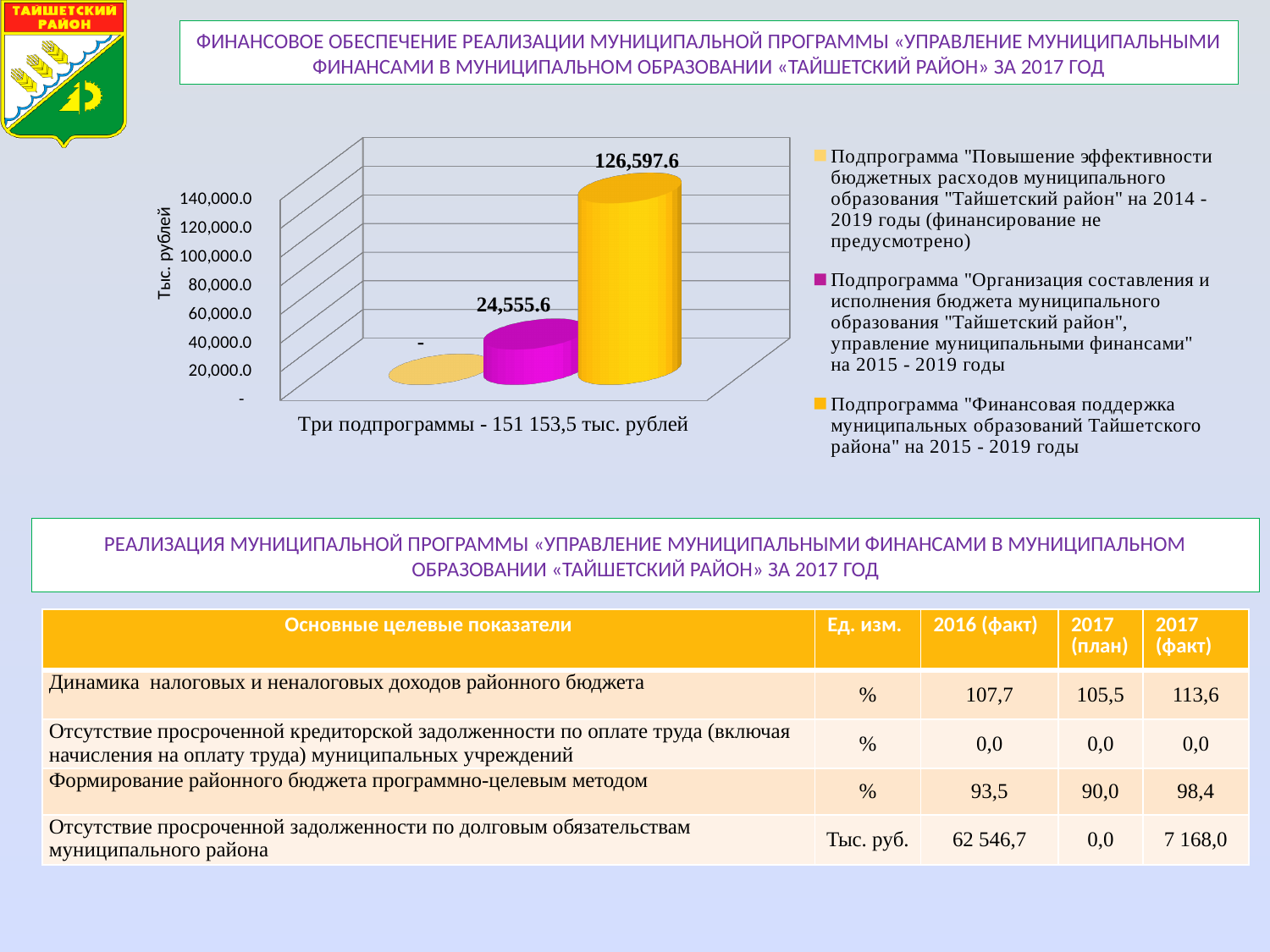
What total amount for the three subprograms is stated in the category label under the chart? 151 153,5 тыс. рублей What is the value for the subprogram "Организация составления и исполнения бюджета муниципального образования "Тайшетский район", управление муниципальными финансами" на 2015 - 2019 годы? 24,555.6 Which is larger: the value for the "Организация составления и исполнения бюджета" subprogram or the "Финансовая поддержка" subprogram? Подпрограмма "Финансовая поддержка муниципальных образований Тайшетского района" на 2015 - 2019 годы How many series does the chart legend list? 3 What unit is shown on the vertical axis of the chart? Тыс. рублей Is the value for the "Финансовая поддержка" subprogram greater or less than 120,000.0? greater What is the value for the subprogram "Финансовая поддержка муниципальных образований Тайшетского района" на 2015 - 2019 годы? 126,597.6 Is the value for the "Организация составления и исполнения бюджета" subprogram greater or less than 40,000.0? less Which subprogram has the highest value in the chart? Подпрограмма "Финансовая поддержка муниципальных образований Тайшетского района" на 2015 - 2019 годы What is the difference between the values for the "Финансовая поддержка" subprogram and the "Организация составления и исполнения бюджета" subprogram? 102,042.0 What kind of chart is shown on the slide? bar chart Which subprogram has the lowest value in the chart? Подпрограмма "Повышение эффективности бюджетных расходов муниципального образования "Тайшетский район" на 2014 - 2019 годы